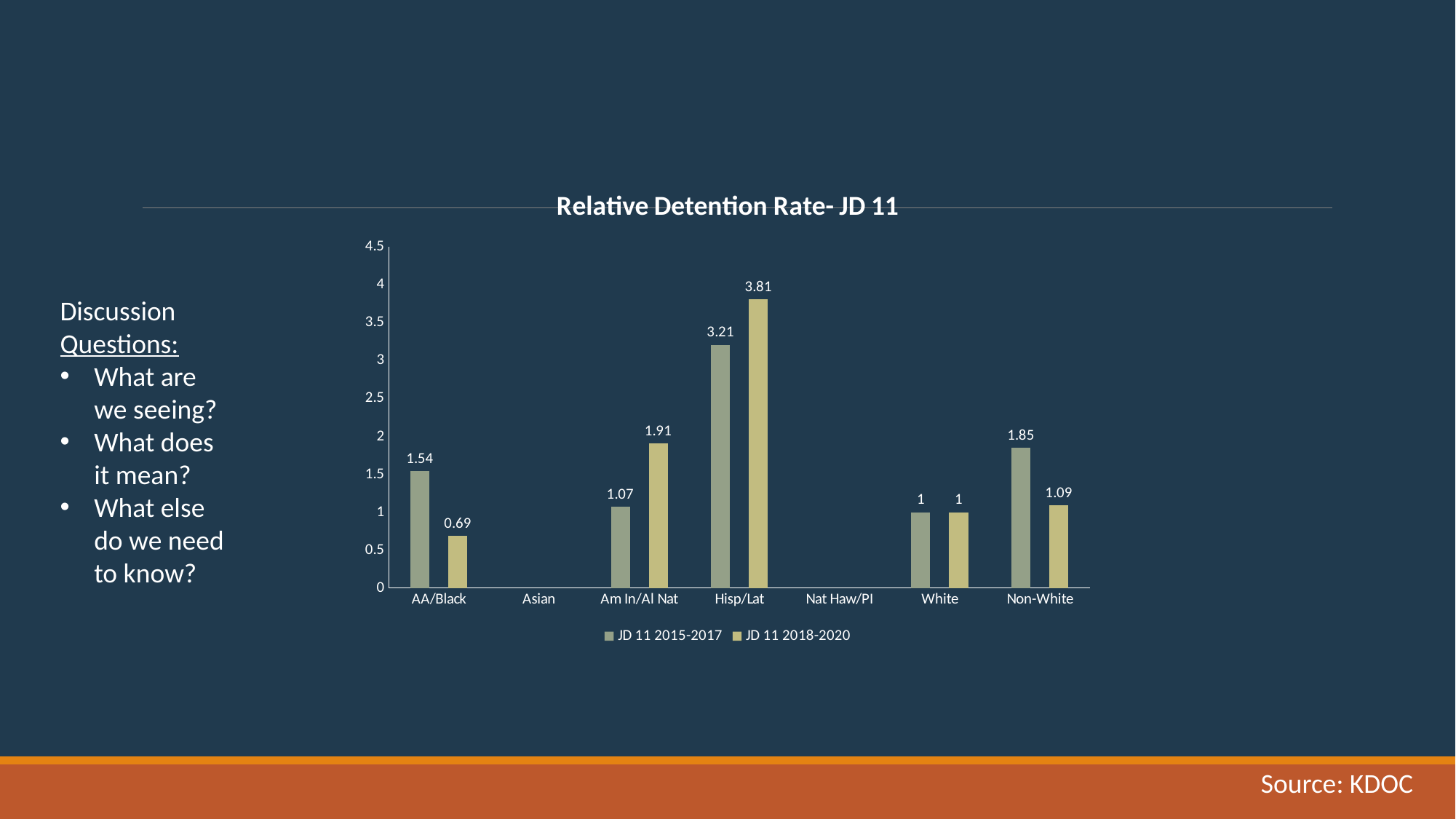
What kind of chart is shown on the slide? Bar chart What is the difference between the JD 11 2018-2020 and JD 11 2015-2017 values for Hisp/Lat? 0.6 What is the value for Hisp/Lat in the JD 11 2018-2020 series? 3.81 Which category has the highest value in the JD 11 2015-2017 series? Hisp/Lat How many series does the legend list? 2 Is the JD 11 2015-2017 value for Am In/Al Nat greater or less than 1.5? less What is the value for AA/Black in the JD 11 2015-2017 series? 1.54 Which category has the lowest value in the JD 11 2018-2020 series among those with a plotted bar? AA/Black How many categories are shown on the x axis? 7 What is the title of the chart? Relative Detention Rate- JD 11 What is the value for Am In/Al Nat in the JD 11 2018-2020 series? 1.91 Which is larger for Non-White: the JD 11 2015-2017 value or the JD 11 2018-2020 value? JD 11 2015-2017